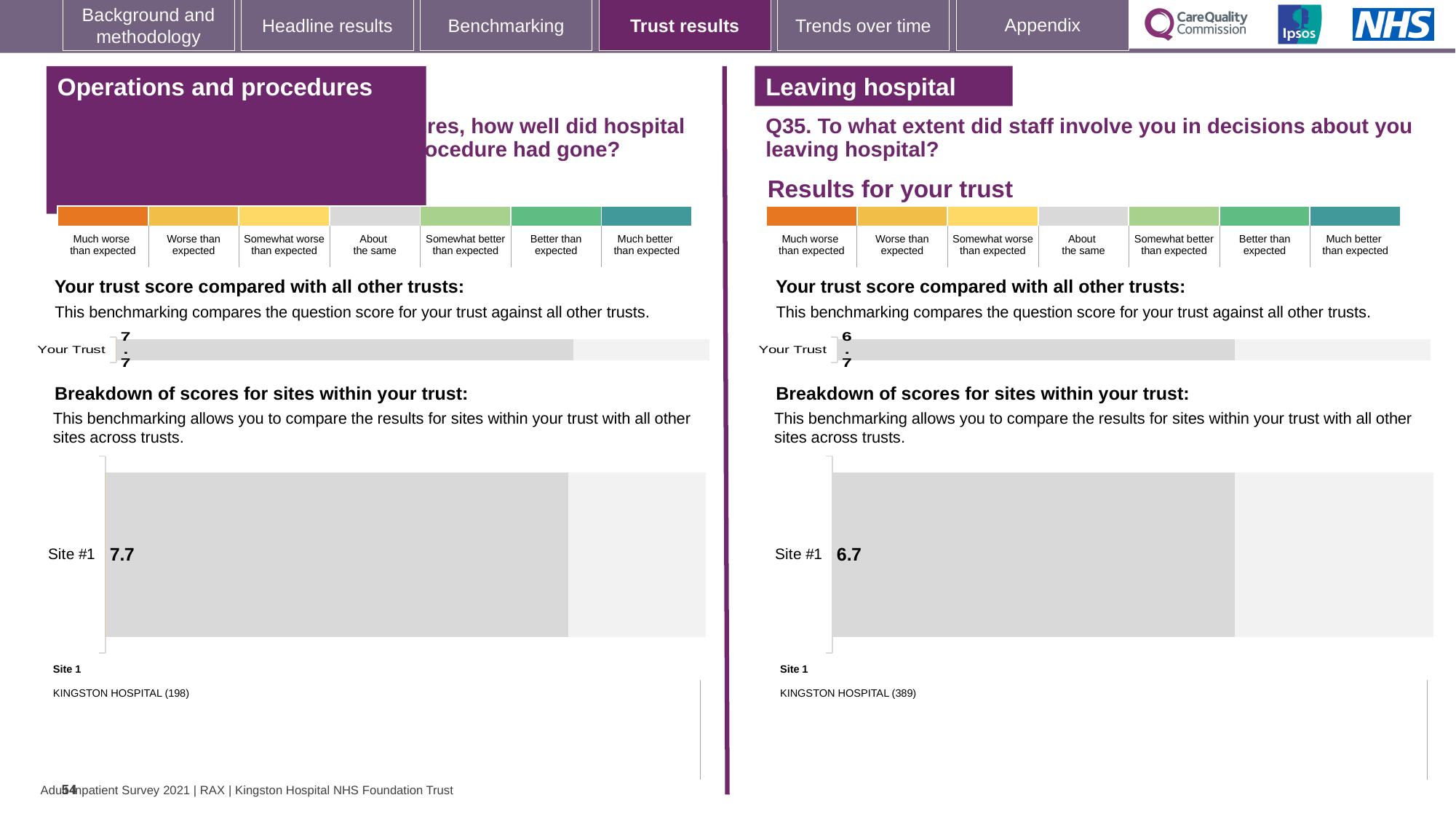
In the Operations and procedures section, what is the score shown for Your Trust in the trust comparison chart? 7.7 In the Operations and procedures section, which site name is listed under Site 1 below the breakdown chart? KINGSTON HOSPITAL (198) Which Site #1 score is higher: the one in the Operations and procedures section or the one in the Leaving hospital section? Operations and procedures Is the Your Trust score in the Leaving hospital section greater or less than the Your Trust score in the Operations and procedures section? less How many sites are shown in the breakdown of scores for sites chart in the Leaving hospital section? 1 In the Leaving hospital section, what is the score shown for Your Trust in the trust comparison chart? 6.7 What is the difference between the Site #1 score in the Operations and procedures section and the Site #1 score in the Leaving hospital section? 1.0 How many sites are shown in the breakdown of scores for sites chart in the Operations and procedures section? 1 In the Leaving hospital section, what score is shown for Site #1 in the breakdown of scores for sites chart? 6.7 What type of chart is used to show the Site #1 score in the Leaving hospital section? Bar chart In the Leaving hospital section, which site name is listed under Site 1 below the breakdown chart? KINGSTON HOSPITAL (389) In the Operations and procedures section, what score is shown for Site #1 in the breakdown of scores for sites chart? 7.7